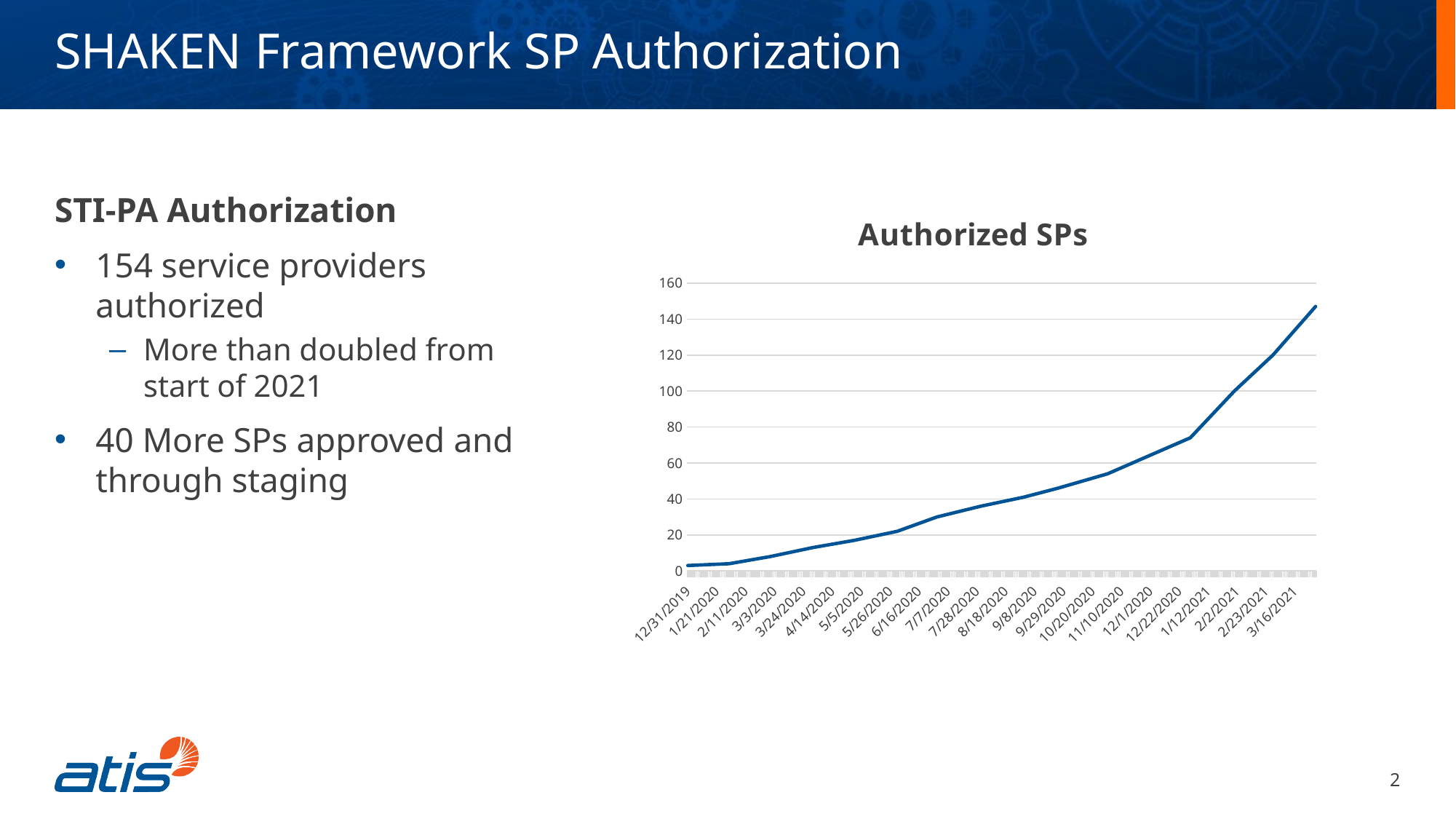
Is the value for 4/14/2020 greater or less than 20? less What kind of chart is shown on the slide? line chart Is the value for 7/7/2020 greater or less than 40? less What is the title of the chart? Authorized SPs At which date is the line at its lowest value? 12/31/2019 Which is larger, the value for 12/22/2020 or the value for 7/7/2020? 12/22/2020 Is the value for 12/22/2020 greater or less than 60? greater Do the values in the Authorized SPs chart rise or fall from 12/31/2019 to 3/16/2021? rise